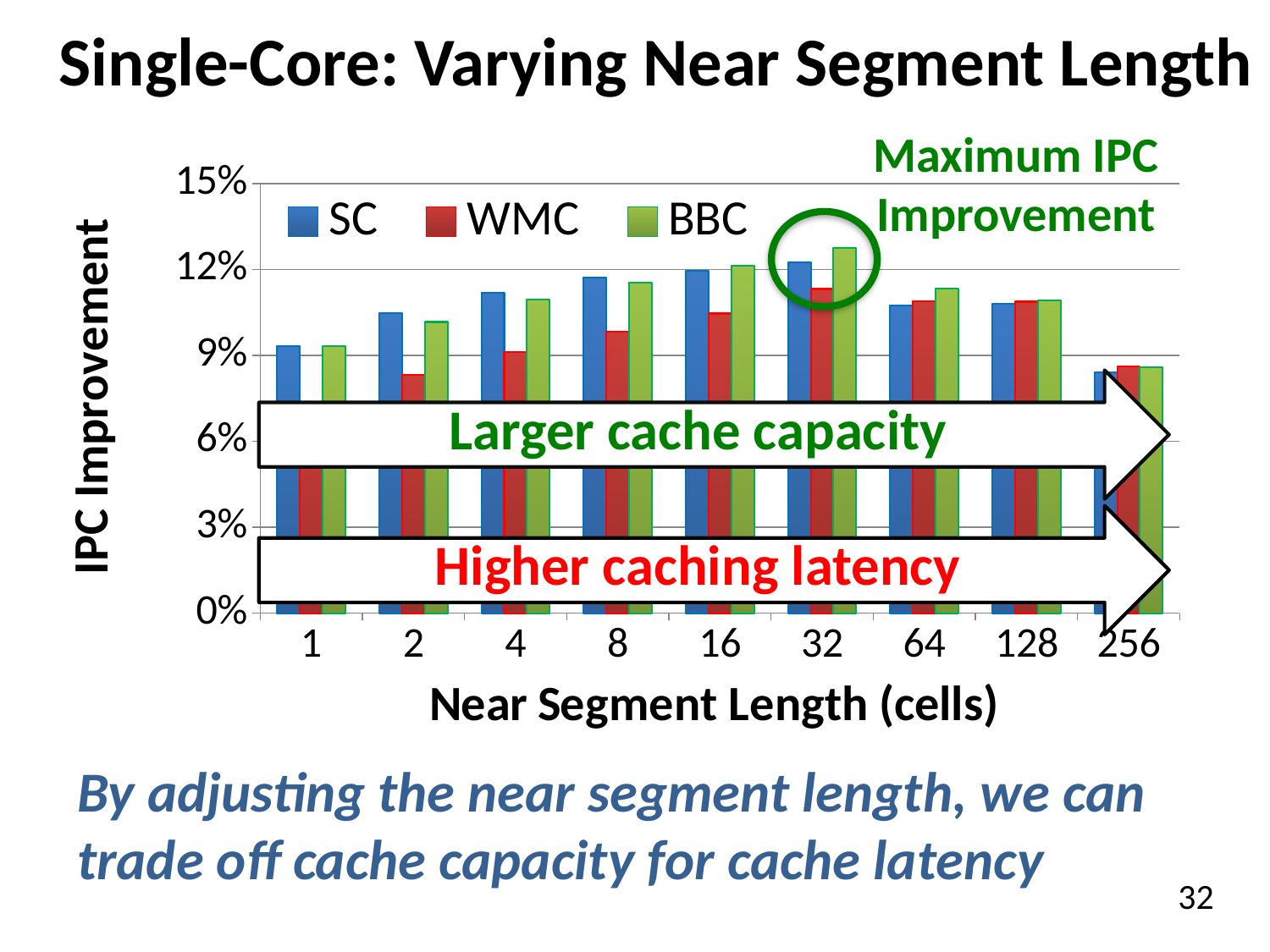
Does the BBC IPC improvement rise or fall from a near segment length of 1 to 32? rise At which near segment length does BBC reach its maximum IPC improvement? 32 Is the SC value at a near segment length of 8 greater or less than 9%? greater At a near segment length of 8, which is larger, the SC value or the WMC value? SC How many near segment length categories are shown on the x axis? 9 What kind of chart is shown on the slide? bar chart Is the WMC value at a near segment length of 2 greater or less than 9%? less Which series has the lowest IPC improvement at a near segment length of 2? WMC Is the BBC value at a near segment length of 32 greater or less than 12%? greater How many series does the legend list? 3 What is the label of the y axis? IPC Improvement Which series has the highest IPC improvement at a near segment length of 32? BBC